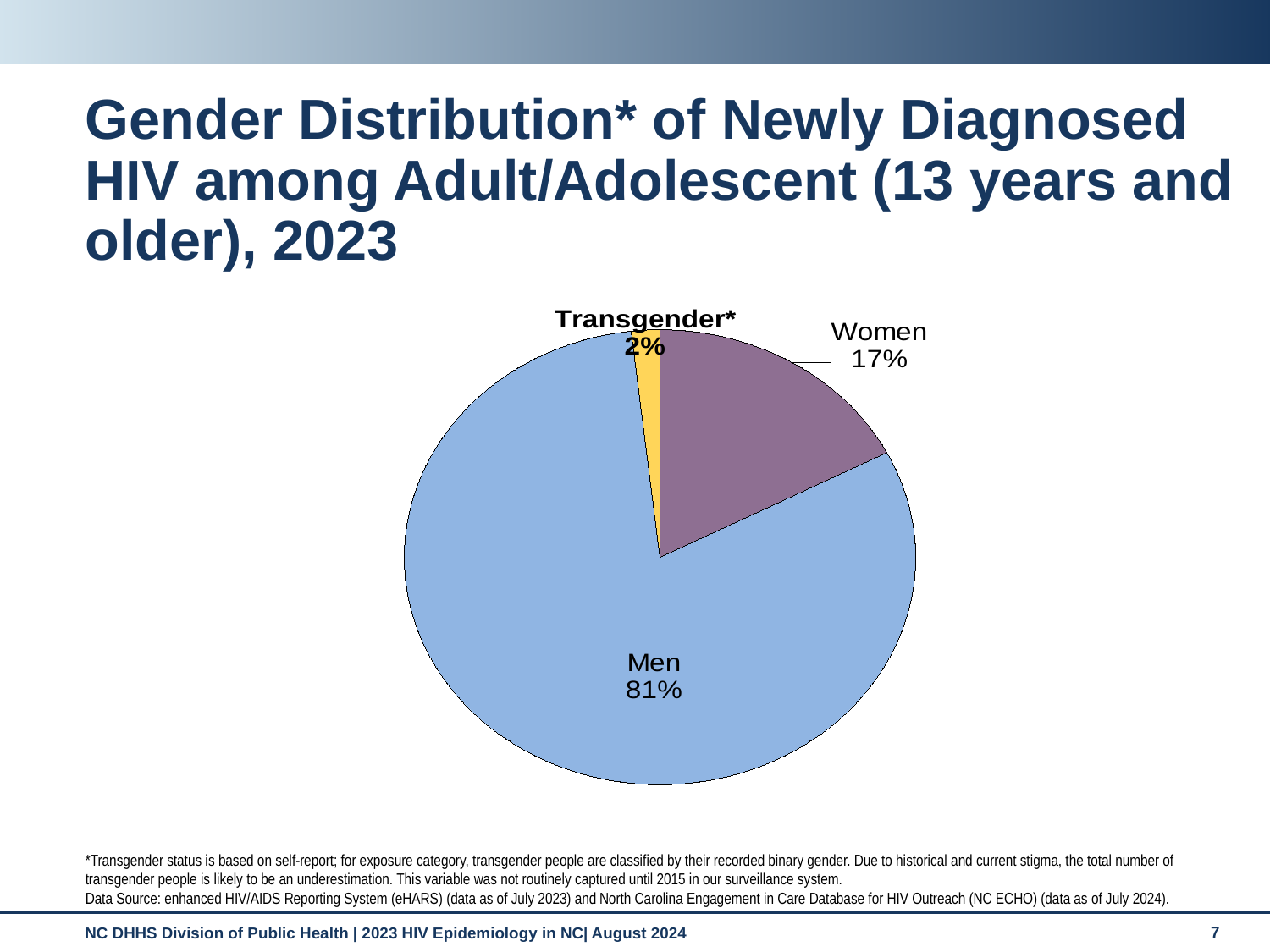
What share of newly diagnosed HIV cases is shown for Men? 81% How many categories are shown in the pie chart? 3 What kind of chart is shown on the slide? pie chart What is the difference in percentage points between the Women and Transgender* slices? 15 Which category has the smallest slice of the pie? Transgender* What year does the chart title say the data is for? 2023 What is the difference in percentage points between the Men and Women slices? 64 Which category has the largest slice of the pie? Men What share of newly diagnosed HIV cases is shown for Women? 17% What colour is the Men slice of the pie? light blue What share of newly diagnosed HIV cases is shown for Transgender*? 2% Which slice is larger, Women or Transgender*? Women